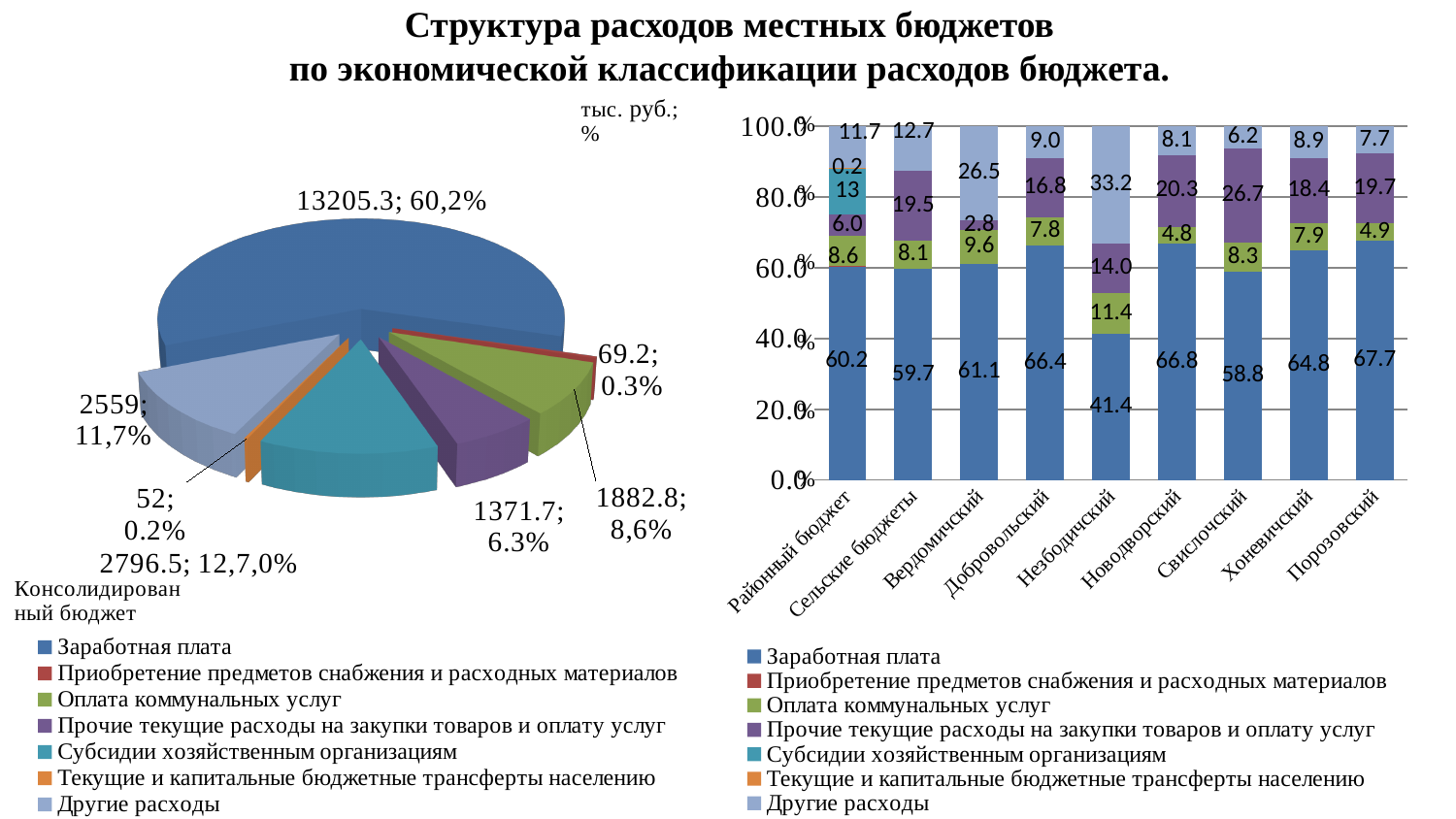
On the left pie chart, what value is shown for the Заработная плата slice? 13205.3; 60,2% On the left pie chart, which category has the smallest slice? Текущие и капитальные бюджетные трансферты населению On the right bar chart, which budget has the highest Заработная плата value? Порозовский What kind of chart is on the left of the slide? Pie chart On the right bar chart, what is the difference between the Заработная плата values for Порозовский and Незбодичский? 26.3 On the left pie chart, what share does the Другие расходы slice have? 11,7% How many categories does the legend of the left pie chart list? 7 On the left pie chart, which category has the largest slice? Заработная плата On the right bar chart, what is the Заработная плата value for Незбодичский? 41.4 On the right bar chart, what is the Другие расходы value for Вердомичский? 26.5 On the right bar chart, how many budgets are shown on the x axis? 9 On the right bar chart, is the Заработная плата value for Свислочский greater or less than 60.0%? less